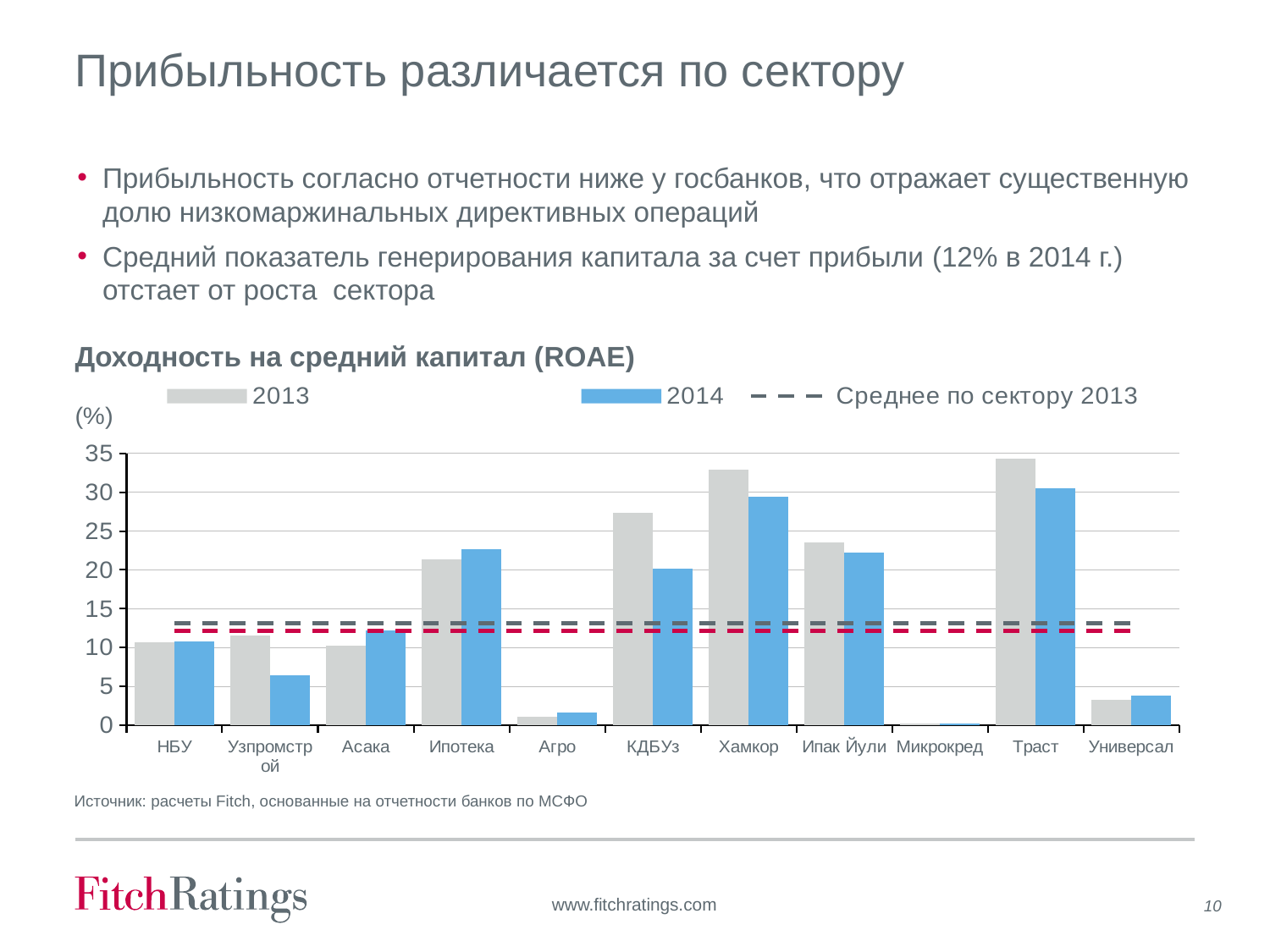
Is the 2014 value for Хамкор greater or less than 25? greater Which bank has the highest 2013 value? Траст How many series does the chart legend list? 3 Is the 2014 value for Ипотека greater or less than 20? greater For КДБУз, which is larger: the 2013 value or the 2014 value? 2013 Which bank has the lowest 2014 value? Микрокред Is the 2013 value for Универсал greater or less than 5? less What kind of chart is shown on the slide? Bar chart What is the title of the chart? Доходность на средний капитал (ROAE) Which bank has the highest 2014 value? Траст How many banks (categories) are shown on the x axis? 11 For Узпромстрой, which is larger: the 2013 value or the 2014 value? 2013